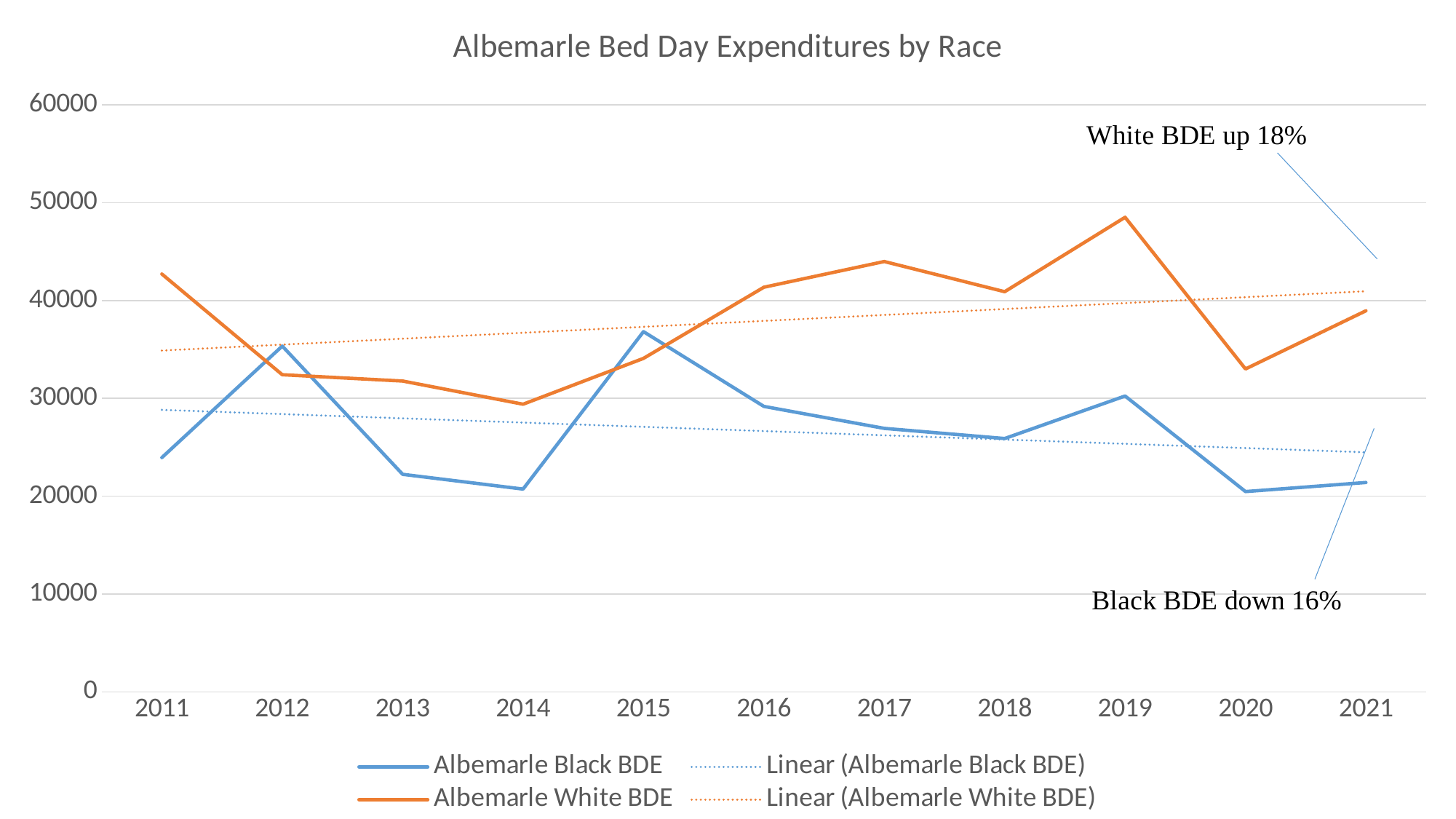
In which year is Albemarle White BDE lowest? 2014 In which year is Albemarle White BDE highest? 2019 According to the annotation on the chart, by what percentage is White BDE up? 18% How many series does the legend list? 4 What is the title of the chart? Albemarle Bed Day Expenditures by Race How many years are plotted along the x axis? 11 Is the value for Albemarle White BDE in 2019 greater or less than 40000? greater What kind of chart is shown on the slide? line chart Is the value for Albemarle Black BDE in 2014 greater or less than 30000? less Does the Linear (Albemarle Black BDE) trendline rise or fall from 2011 to 2021? fall In 2011, which is larger, Albemarle Black BDE or Albemarle White BDE? Albemarle White BDE In 2012, which is larger, Albemarle Black BDE or Albemarle White BDE? Albemarle Black BDE